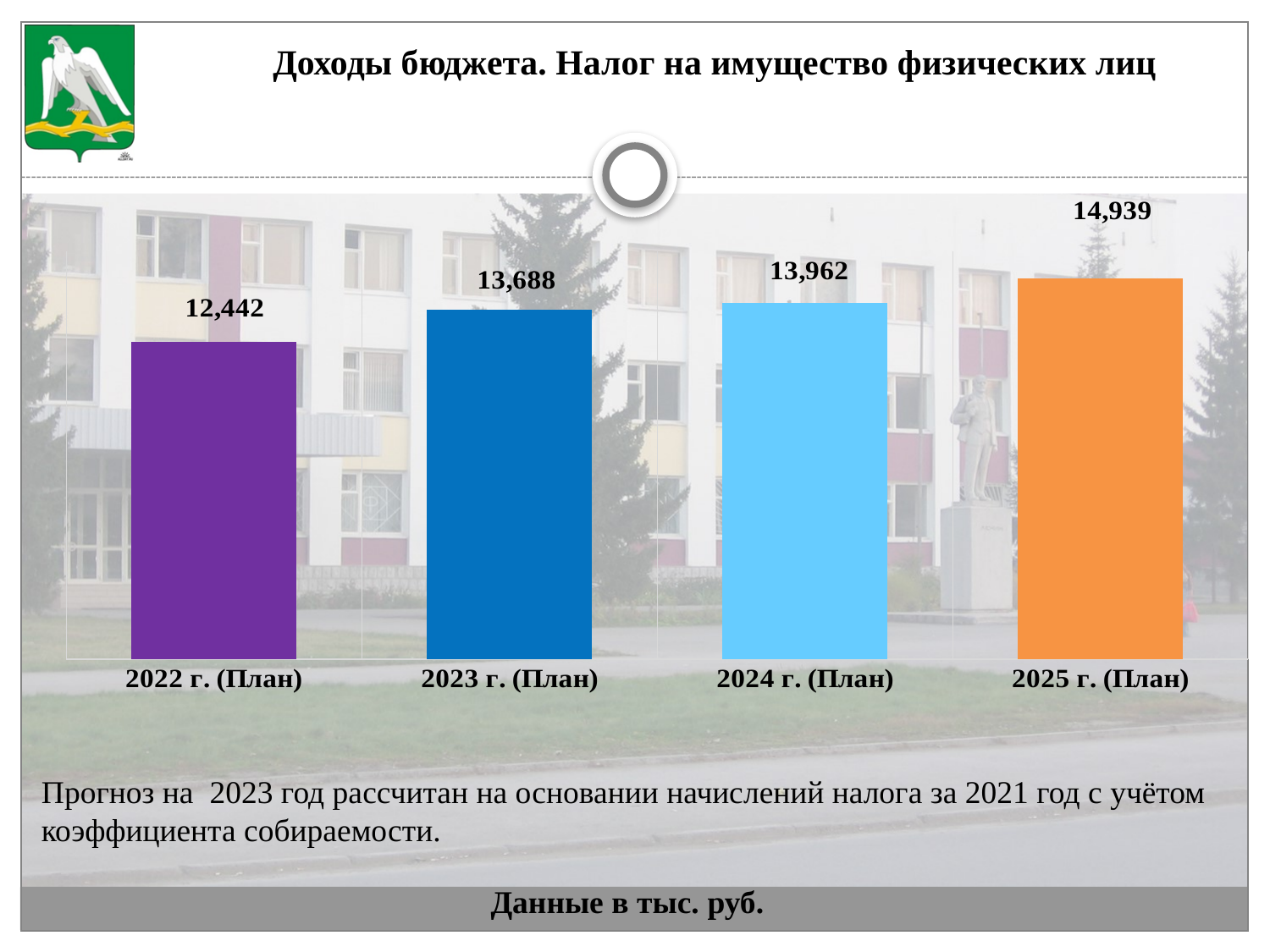
Which year has the lowest value? 2022 г. (План) What is the value for 2024 г. (План)? 13,962 What is the difference between the values for 2024 г. (План) and 2023 г. (План)? 274 How many categories are shown in the chart? 4 Which is larger, the value for 2023 г. (План) or 2025 г. (План)? 2025 г. (План) Do the values rise or fall from 2022 to 2025? Rise What is the value for 2022 г. (План)? 12,442 What is the difference between the values for 2025 г. (План) and 2022 г. (План)? 2,497 Which year has the highest value? 2025 г. (План) What kind of chart is shown on the slide? Bar chart What is the value for 2023 г. (План)? 13,688 What is the value for 2025 г. (План)? 14,939